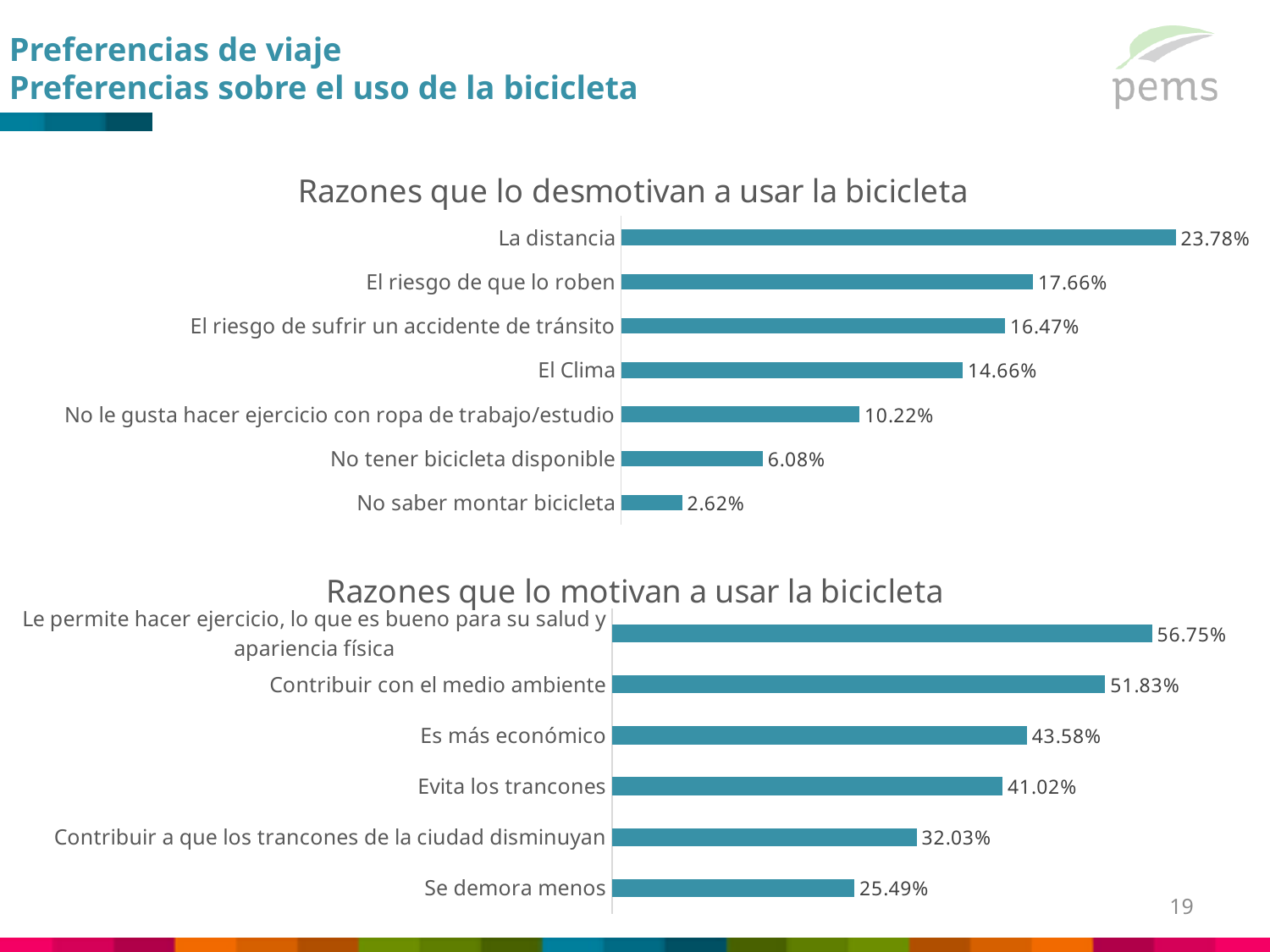
What type of chart is 'Razones que lo motivan a usar la bicicleta'? Bar chart In the chart 'Razones que lo motivan a usar la bicicleta', how many categories are shown? 6 In the chart 'Razones que lo motivan a usar la bicicleta', what is the difference between 'Contribuir con el medio ambiente' and 'Se demora menos'? 26.34% In the chart 'Razones que lo desmotivan a usar la bicicleta', what is the difference between 'El riesgo de que lo roben' and 'El riesgo de sufrir un accidente de tránsito'? 1.19% In the chart 'Razones que lo motivan a usar la bicicleta', which category has the lowest value? Se demora menos In the chart 'Razones que lo motivan a usar la bicicleta', which is larger: 'Evita los trancones' or 'Contribuir a que los trancones de la ciudad disminuyan'? Evita los trancones In the chart 'Razones que lo desmotivan a usar la bicicleta', which category has the lowest value? No saber montar bicicleta In the chart 'Razones que lo desmotivan a usar la bicicleta', how many categories are shown? 7 In the chart 'Razones que lo desmotivan a usar la bicicleta', what is the value for 'El Clima'? 14.66% In the chart 'Razones que lo desmotivan a usar la bicicleta', which category has the highest value? La distancia In the chart 'Razones que lo motivan a usar la bicicleta', which category has the highest value? Le permite hacer ejercicio, lo que es bueno para su salud y apariencia física In the chart 'Razones que lo motivan a usar la bicicleta', what is the value for 'Es más económico'? 43.58%